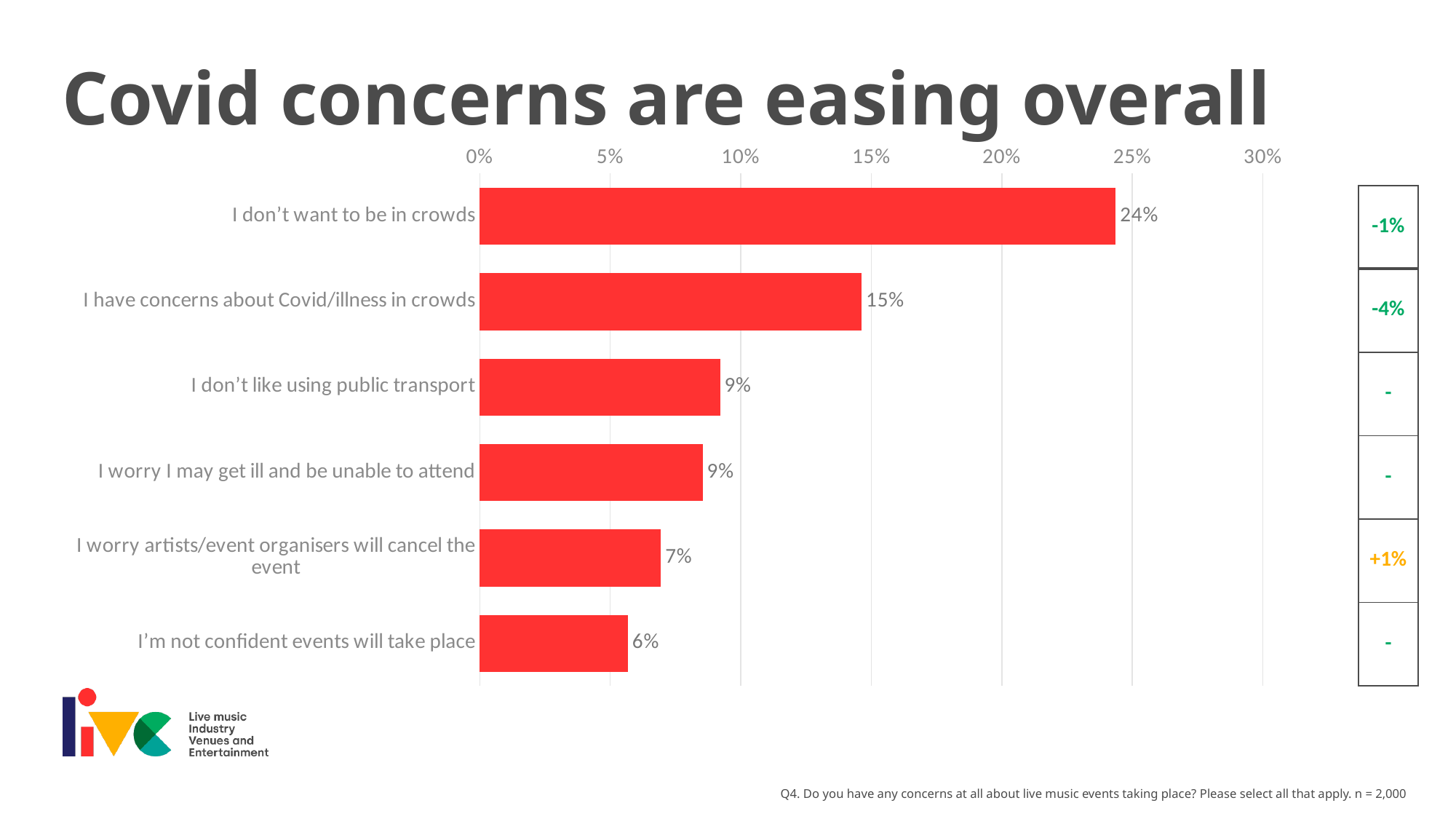
Is the value for "I don't want to be in crowds" greater or less than 20%? greater What is the value for "I'm not confident events will take place"? 6% What is the title of the slide? Covid concerns are easing overall What is the value for "I have concerns about Covid/illness in crowds"? 15% What is the difference in percentage points between "I don't want to be in crowds" and "I have concerns about Covid/illness in crowds"? 9% Which concern has the lowest percentage? I'm not confident events will take place How many concern categories are shown in the chart? 6 What type of chart is shown on the slide? Bar chart What percentage of respondents said "I don't want to be in crowds"? 24% Which is larger: the value for "I have concerns about Covid/illness in crowds" or the value for "I don't like using public transport"? I have concerns about Covid/illness in crowds What is the value for "I worry artists/event organisers will cancel the event"? 7% Which concern has the highest percentage? I don't want to be in crowds